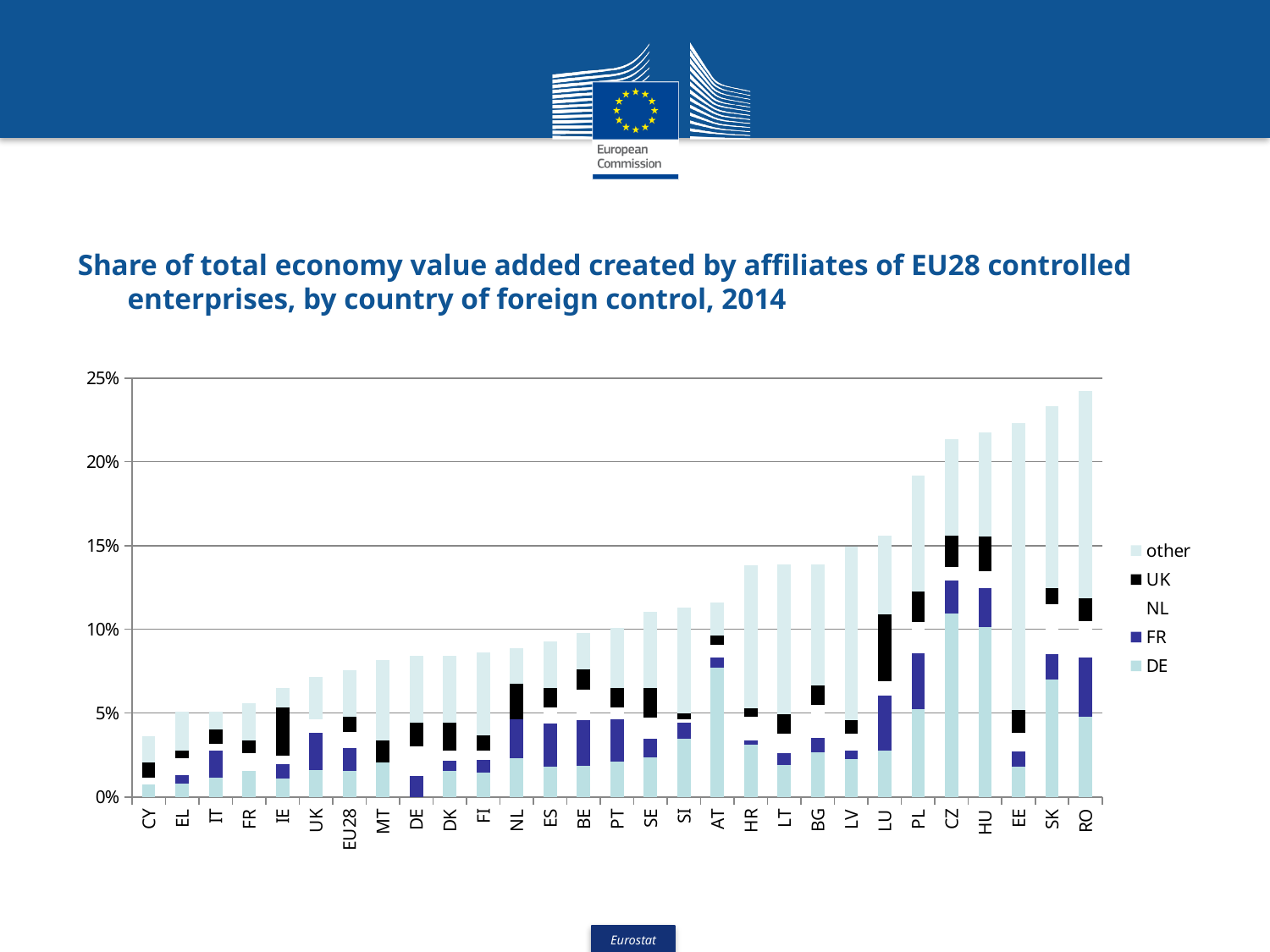
How many series does the legend list? 5 Do the total values generally rise or fall from left to right along the x axis? rise Is the total value for HR greater or less than 15%? less Is the total value for CY greater or less than 5%? less Is the total value for RO greater or less than 20%? greater Which country has the lowest total share? CY Which has the larger total share, PL or HR? PL How many countries (categories) are shown on the x axis? 29 Which series is listed first in the legend? other Which country has the highest total share? RO What kind of chart is shown on the slide? stacked bar chart